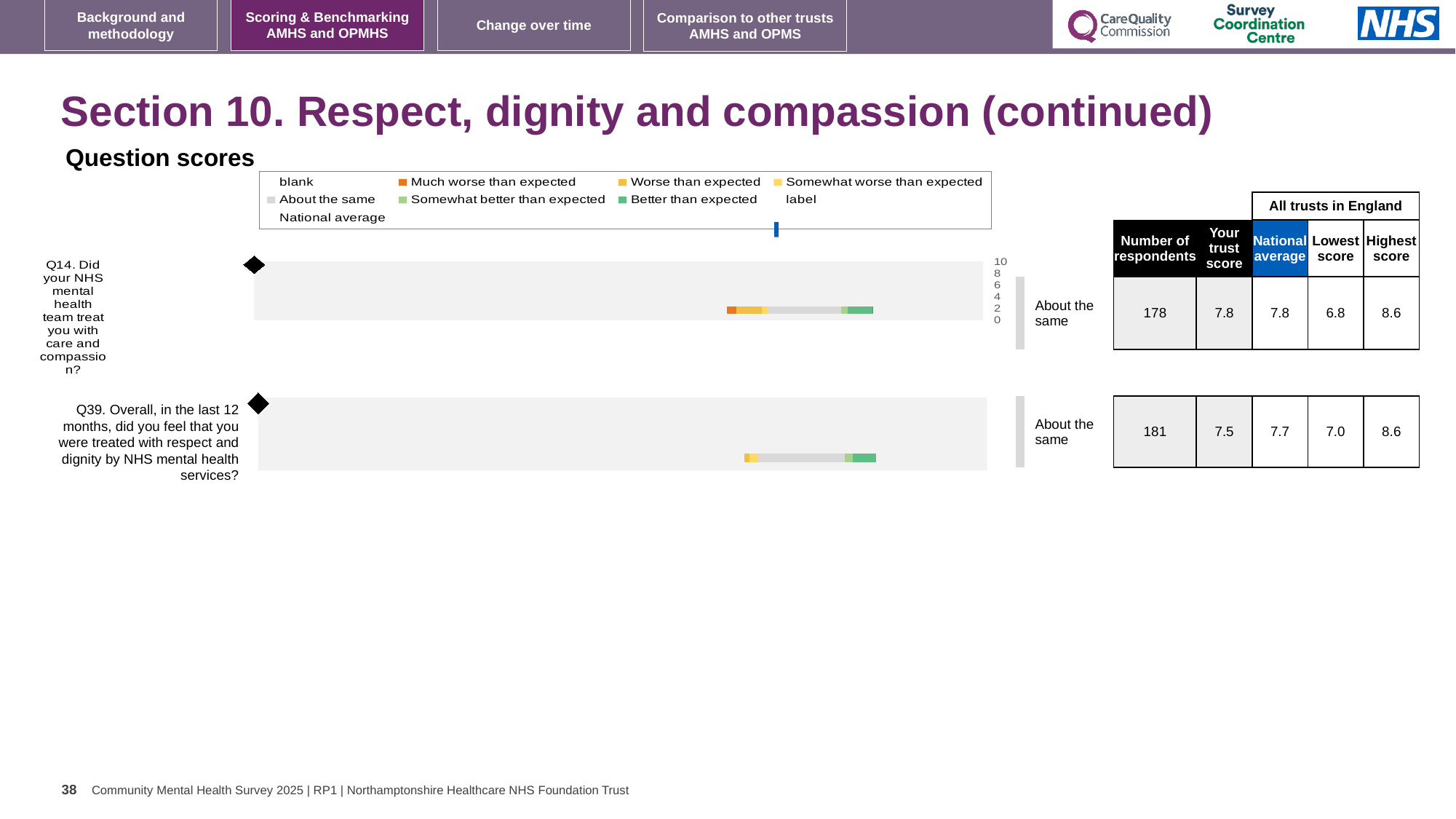
What is the national average for Q39? 7.7 What is the lowest score across all trusts in England for Q14? 6.8 What is the difference between the national average and the trust score for Q39? 0.2 What benchmark category is shown next to the Q14 bar? About the same What is the difference between the highest and lowest scores for Q14? 1.8 What is the trust score for Q39 (respect and dignity)? 7.5 What is the trust score for Q14 (care and compassion)? 7.8 Which question has the higher trust score, Q14 or Q39? Q14 How many questions are plotted in the question scores chart? 2 What kind of chart is used to show the question scores on this slide? bar chart How many entries does the legend of the question scores chart list? 9 How many respondents answered Q14? 178